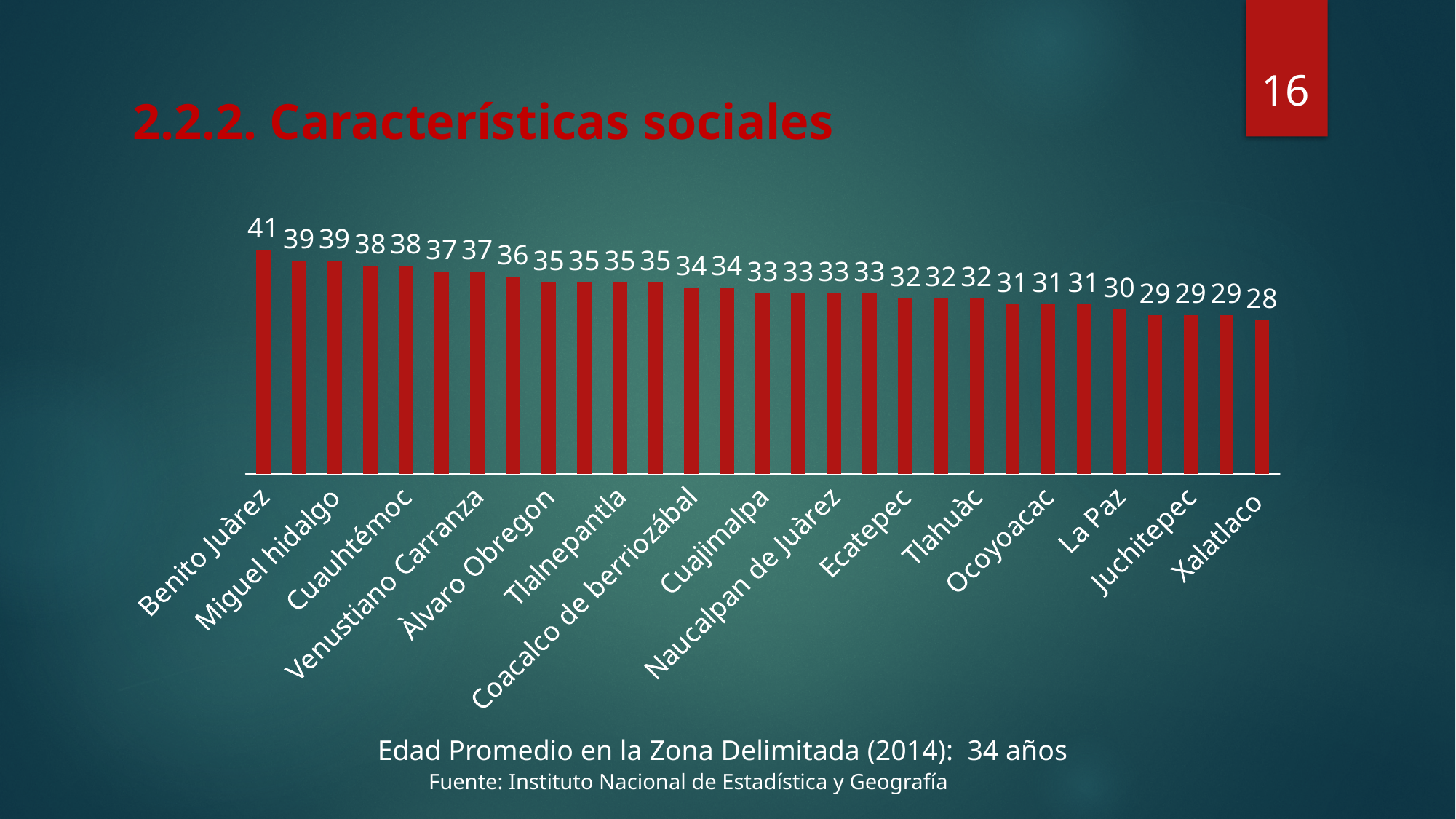
What colour are the bars in the chart? red How many bars are plotted in the chart? 29 What is the value for Benito Juàrez? 41 Do the values rise or fall from left to right along the x axis? fall According to the text below the chart, what is the average age in the delimited zone (2014)? 34 años What kind of chart is shown on the slide? bar chart What is the highest value shown in the chart? 41 Which is larger, the value for Benito Juàrez or the value for Xalatlaco? Benito Juàrez What is the difference between the values for Benito Juàrez and Xalatlaco? 13 Which category has the lowest value in the chart? Xalatlaco Which category has the highest value in the chart? Benito Juàrez What is the value for Xalatlaco? 28